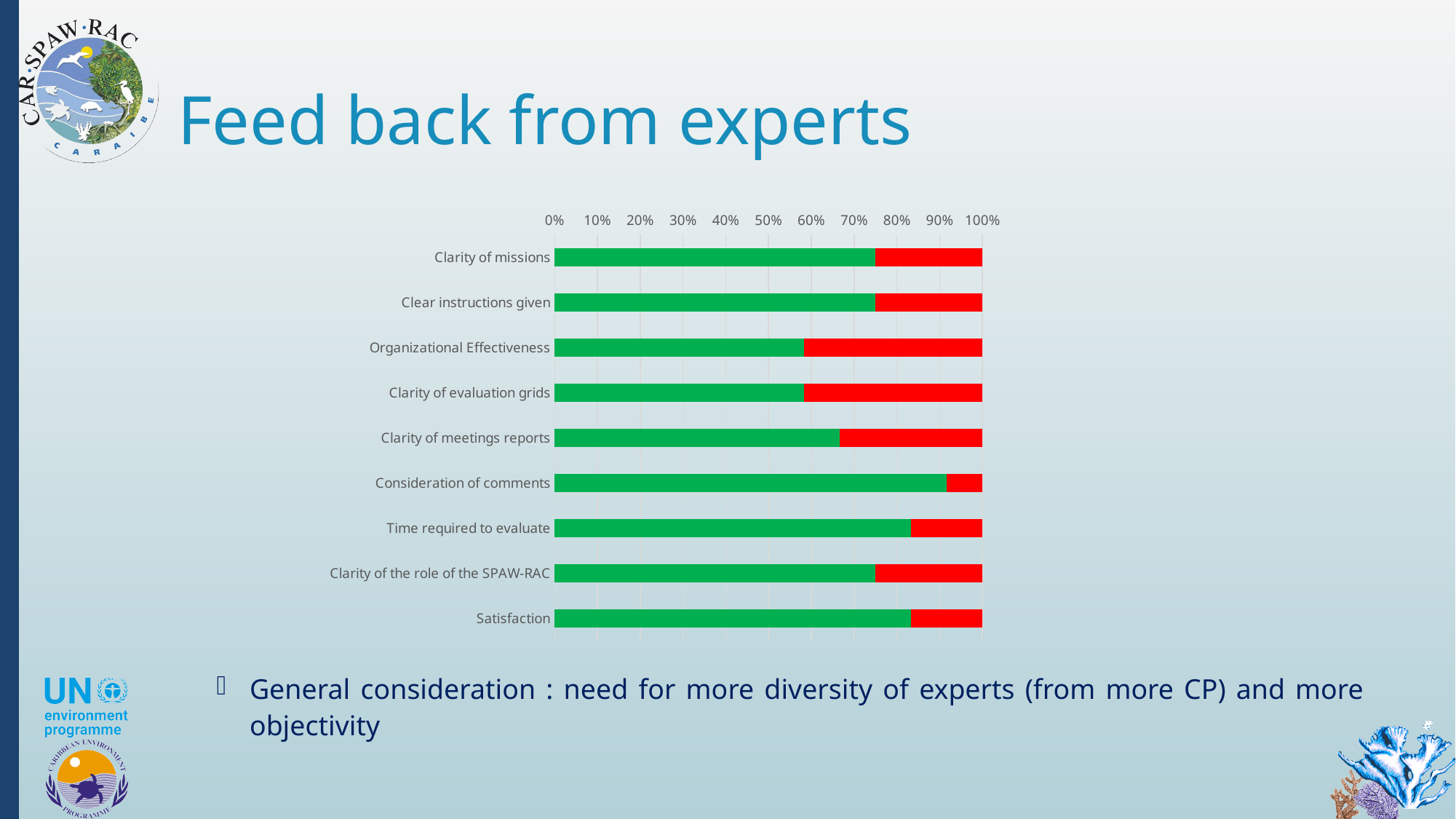
What kind of chart is shown on the slide? Stacked bar chart How many categories are plotted on the chart? 9 Which has the larger red segment, Organizational Effectiveness or Satisfaction? Organizational Effectiveness Is the green segment for Consideration of comments greater or less than 90%? greater Which category has the largest green segment? Consideration of comments Is the green segment for Clarity of meetings reports greater or less than 70%? less Is the green segment for Organizational Effectiveness greater or less than 60%? less What two colours are used for the segments of each bar? Green and red Which has the larger green segment, Consideration of comments or Clarity of evaluation grids? Consideration of comments What is the title of the slide containing the chart? Feed back from experts What value does each stacked bar total on the axis? 100%